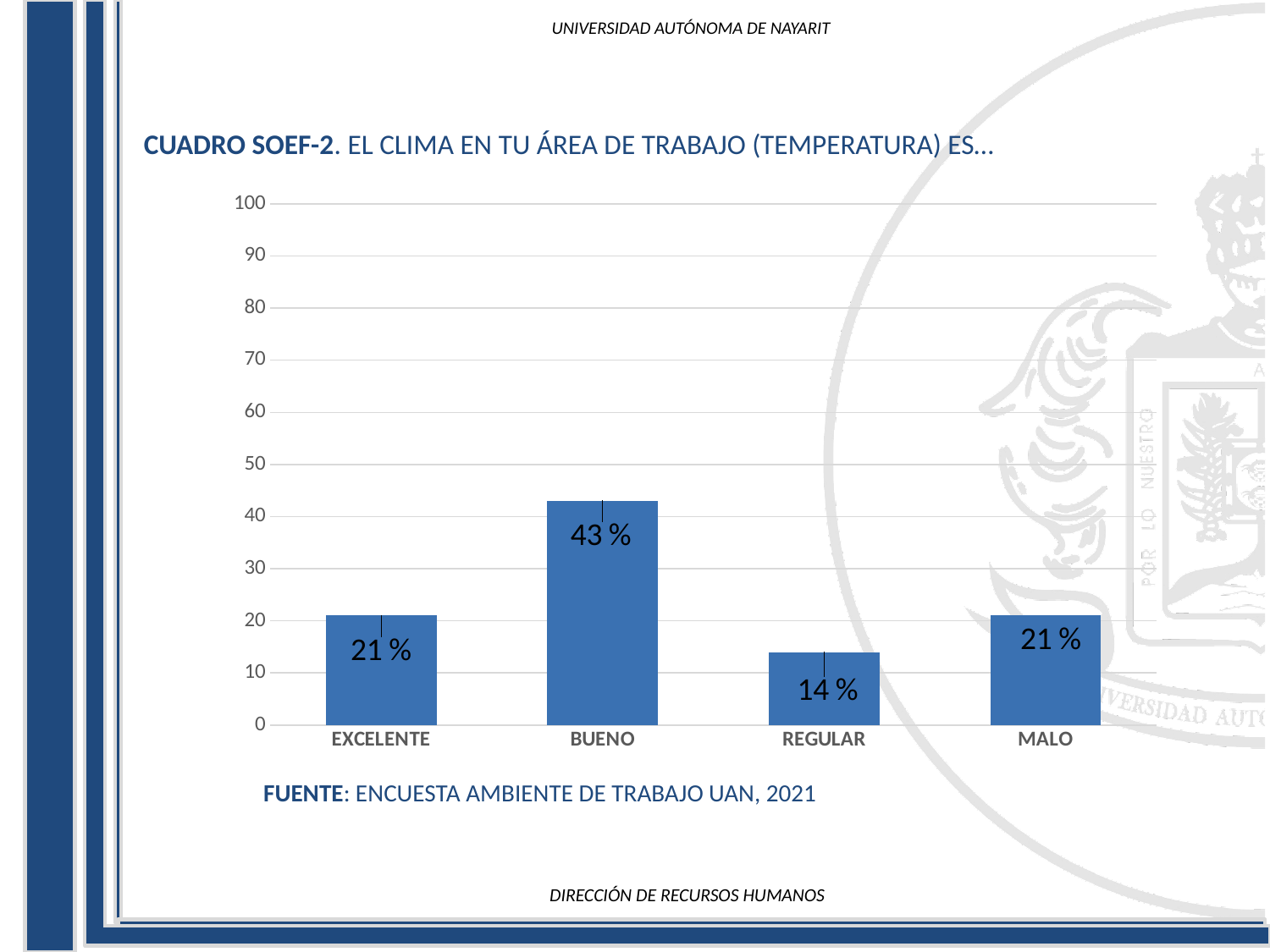
What is the value for EXCELENTE? 21 % What is the value for REGULAR? 14 % Which category has the highest value? BUENO What is the title of the chart? CUADRO SOEF-2. EL CLIMA EN TU ÁREA DE TRABAJO (TEMPERATURA) ES… Is the value for BUENO greater or less than 40? greater Which category has the lowest value? REGULAR Which is larger, the value for BUENO or the value for MALO? BUENO What is the difference between the values for MALO and REGULAR? 7 % What kind of chart is shown on the slide? bar chart How many categories are shown on the x axis? 4 What is the value for BUENO? 43 % What is the difference between the values for BUENO and REGULAR? 29 %